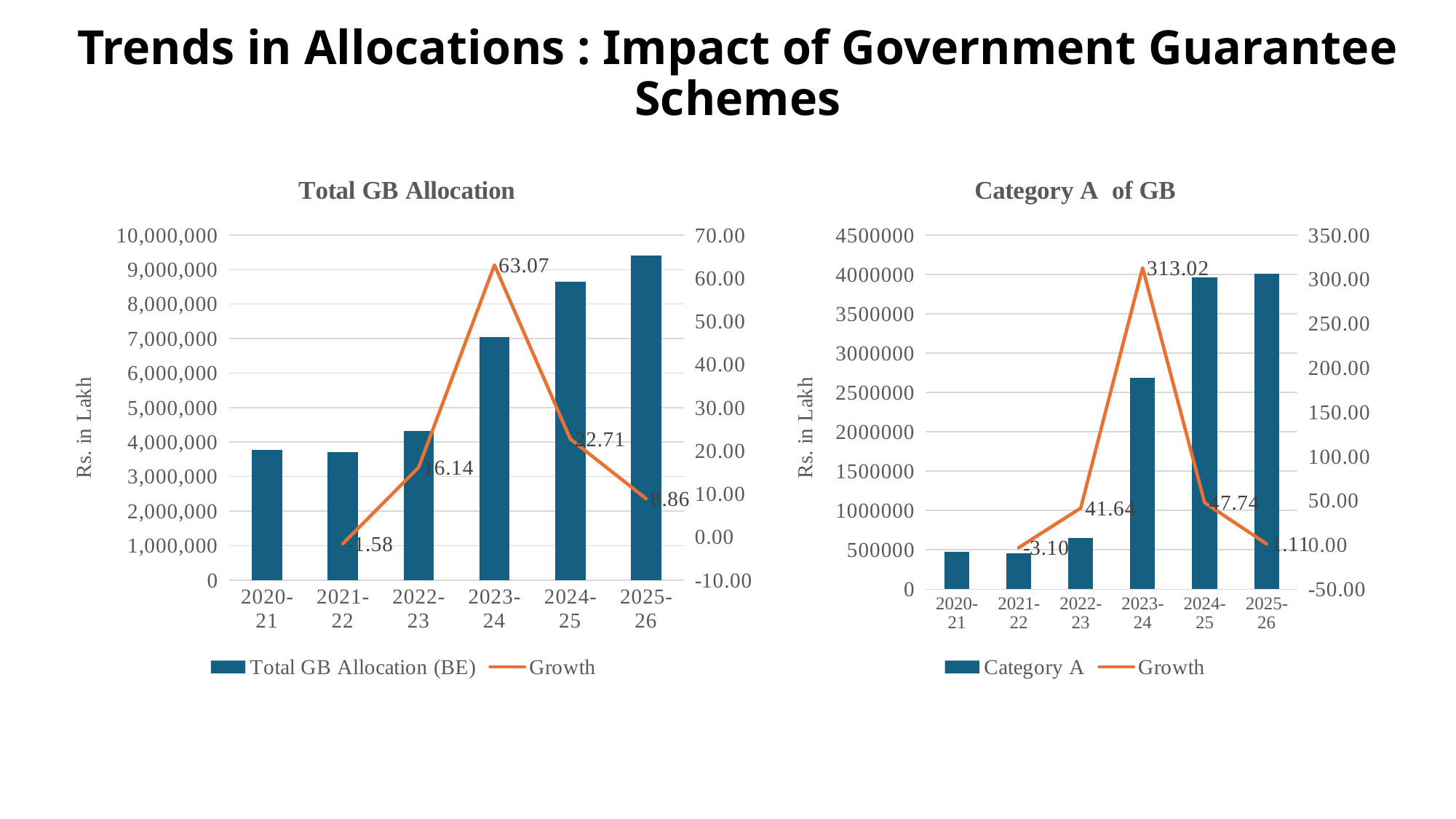
In the Category A of GB chart, which year has the larger Category A bar, 2022-23 or 2023-24? 2023-24 How many series does the legend of the Total GB Allocation chart list? 2 In the Total GB Allocation chart, what is the difference between the Growth values for 2023-24 and 2024-25? 40.36 How many years are shown on the x axis of the Total GB Allocation chart? 6 In the Category A of GB chart, what is the difference between the Growth values for 2023-24 and 2024-25? 265.28 In the Category A of GB chart, what is the Growth value for 2023-24? 313.02 In the Total GB Allocation chart, is the Total GB Allocation (BE) bar for 2025-26 greater or less than 9,000,000? greater In the Category A of GB chart, what is the Growth value for 2022-23? 41.64 In the Total GB Allocation chart, what is the Growth value for 2023-24? 63.07 In the Total GB Allocation chart, what is the Growth value for 2021-22? -1.58 In the Category A of GB chart, is the Category A bar for 2023-24 greater or less than 2500000? greater In the Total GB Allocation chart, which year has the highest Growth value? 2023-24